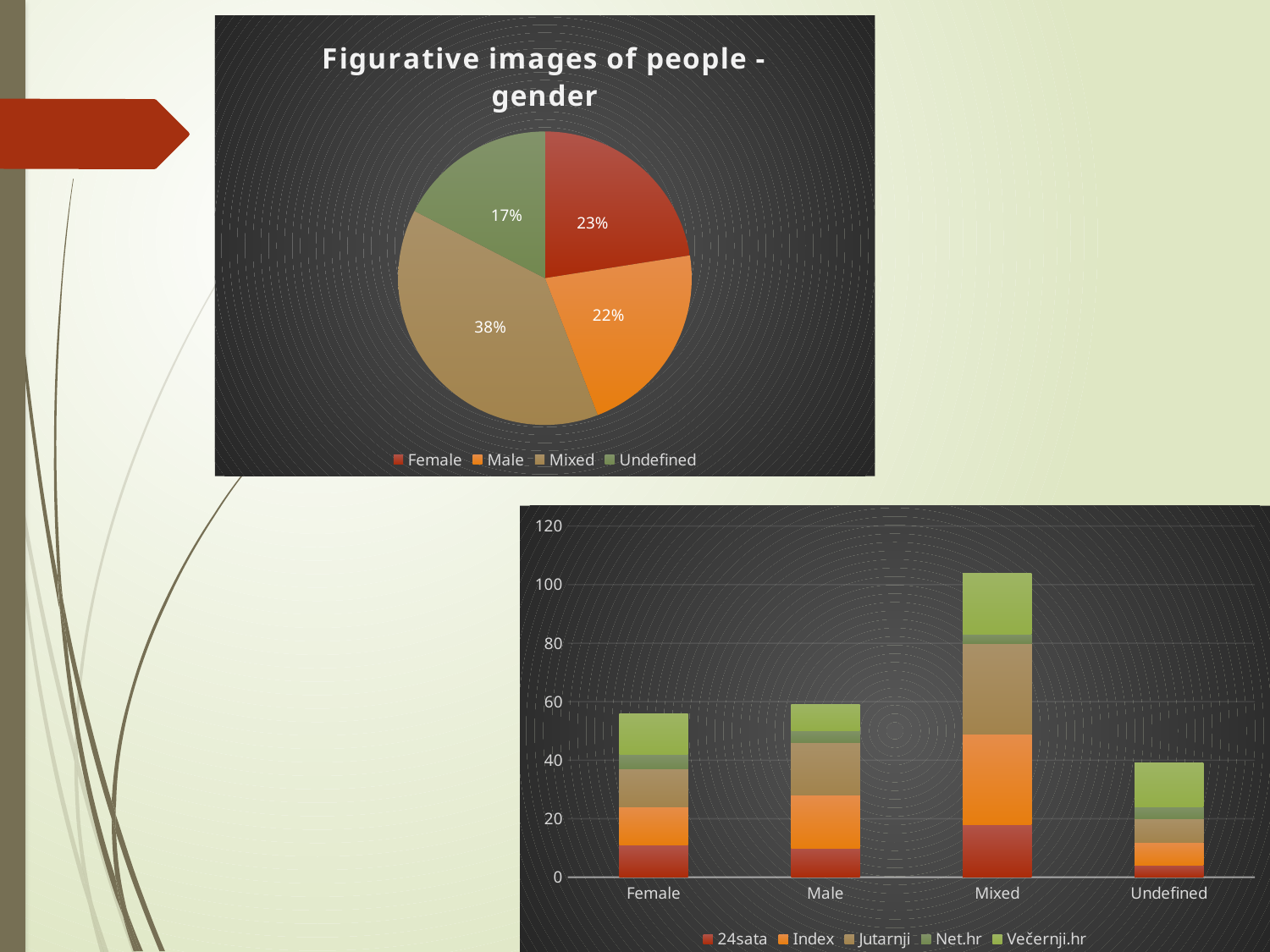
In the pie chart titled "Figurative images of people - gender", which category has the largest slice? Mixed In the stacked bar chart at the bottom right of the slide, how many series does the legend list? 5 In the pie chart titled "Figurative images of people - gender", how many categories does the legend list? 4 In the stacked bar chart at the bottom right of the slide, is the total for Mixed greater or less than 80? greater In the pie chart titled "Figurative images of people - gender", which category has the smallest slice? Undefined What kind of chart is the chart at the bottom right of the slide? Stacked bar chart In the pie chart titled "Figurative images of people - gender", what share does the Mixed slice have? 38% In the stacked bar chart at the bottom right of the slide, which category has the tallest bar? Mixed In the pie chart titled "Figurative images of people - gender", what is the difference in percentage points between the Mixed and Male slices? 16 In the stacked bar chart at the bottom right of the slide, is the total for Undefined greater or less than 60? less In the pie chart titled "Figurative images of people - gender", what percentage is shown for Female? 23% In the pie chart titled "Figurative images of people - gender", what percentage is shown for Undefined? 17%